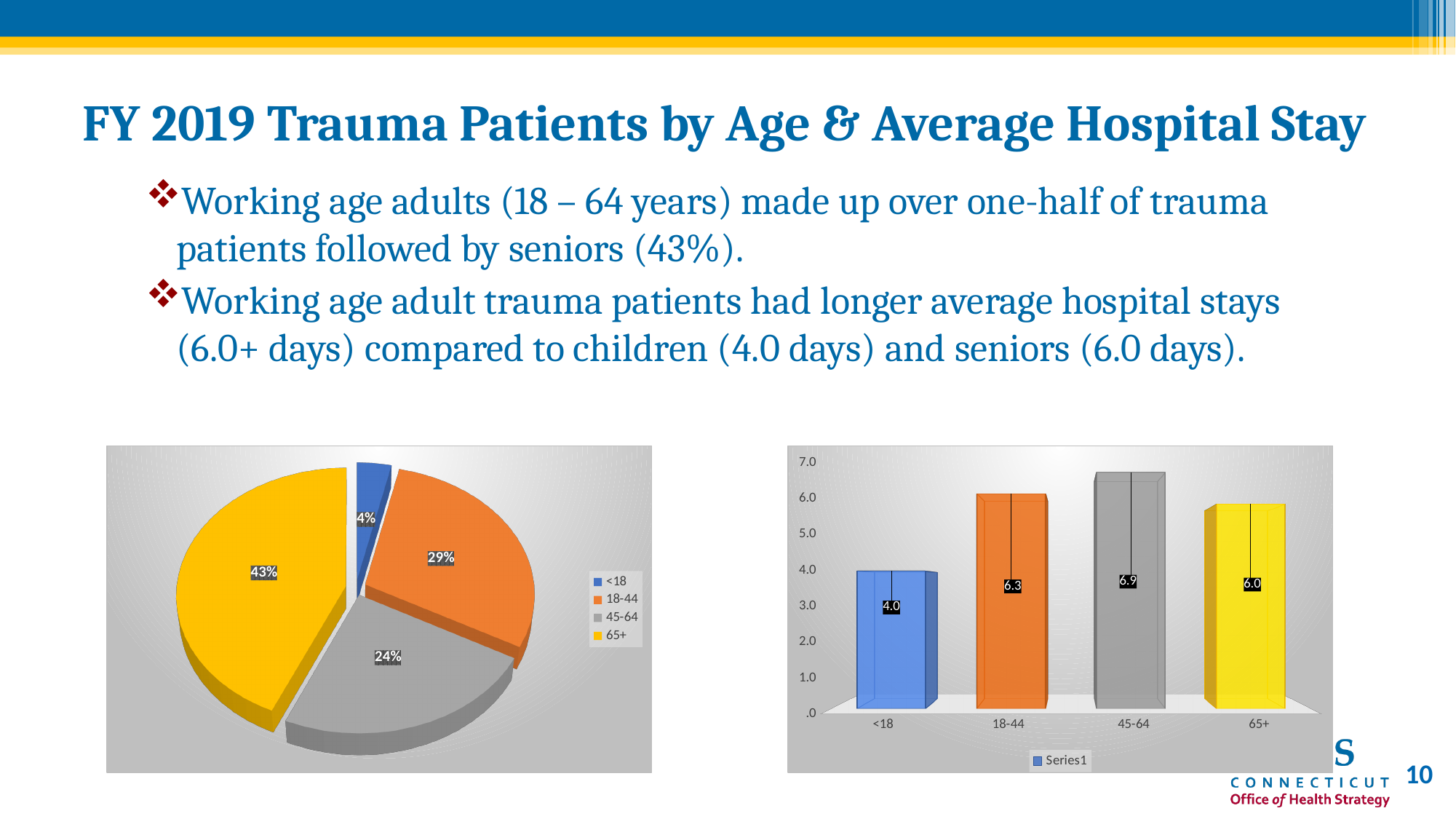
In the pie chart on the left, how many age groups are shown? 4 What type of chart is shown on the right side of the slide? Bar chart In the pie chart on the left, what share of trauma patients were aged 18-44? 29% In the pie chart on the left, what is the difference in percentage points between the 18-44 and 45-64 slices? 5 In the bar chart on the right, what is the average hospital stay for the <18 age group? 4.0 In the bar chart on the right, what is the difference between the values for 45-64 and 65+? 0.9 In the pie chart on the left, what share of trauma patients were aged 65+? 43% In the pie chart on the left, which age group has the smallest share? <18 In the bar chart on the right, what is the average hospital stay for the 45-64 age group? 6.9 In the bar chart on the right, which age group has the longest average hospital stay? 45-64 In the pie chart on the left, which age group has the largest share? 65+ In the bar chart on the right, which is larger, the value for 18-44 or the value for 65+? 18-44